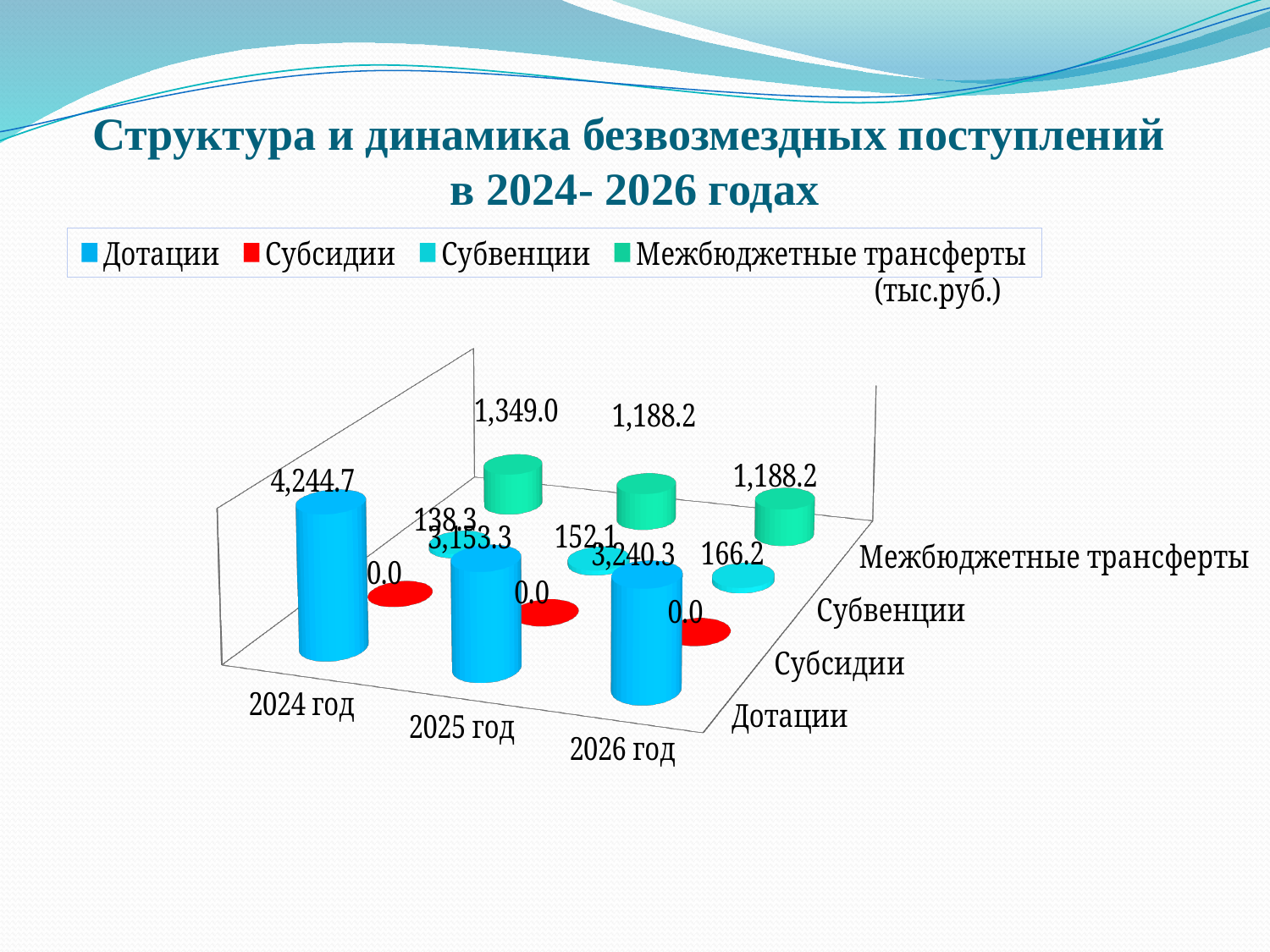
How many series does the legend list? 4 What kind of chart is shown on the slide? Bar chart Which is larger: Межбюджетные трансферты in 2024 год or in 2025 год? 2024 год What is the value for Субсидии in 2025 год? 0.0 What is the value for Дотации in 2026 год? 3,240.3 What is the value for Межбюджетные трансферты in 2024 год? 1,349.0 In which year is the value for Дотации highest? 2024 год What is the value for Дотации in 2024 год? 4,244.7 How many years are shown on the chart? 3 In which year is the value for Субвенции lowest? 2024 год What is the value for Субвенции in 2026 год? 166.2 What is the difference between the Дотации values for 2024 год and 2025 год? 1,091.4